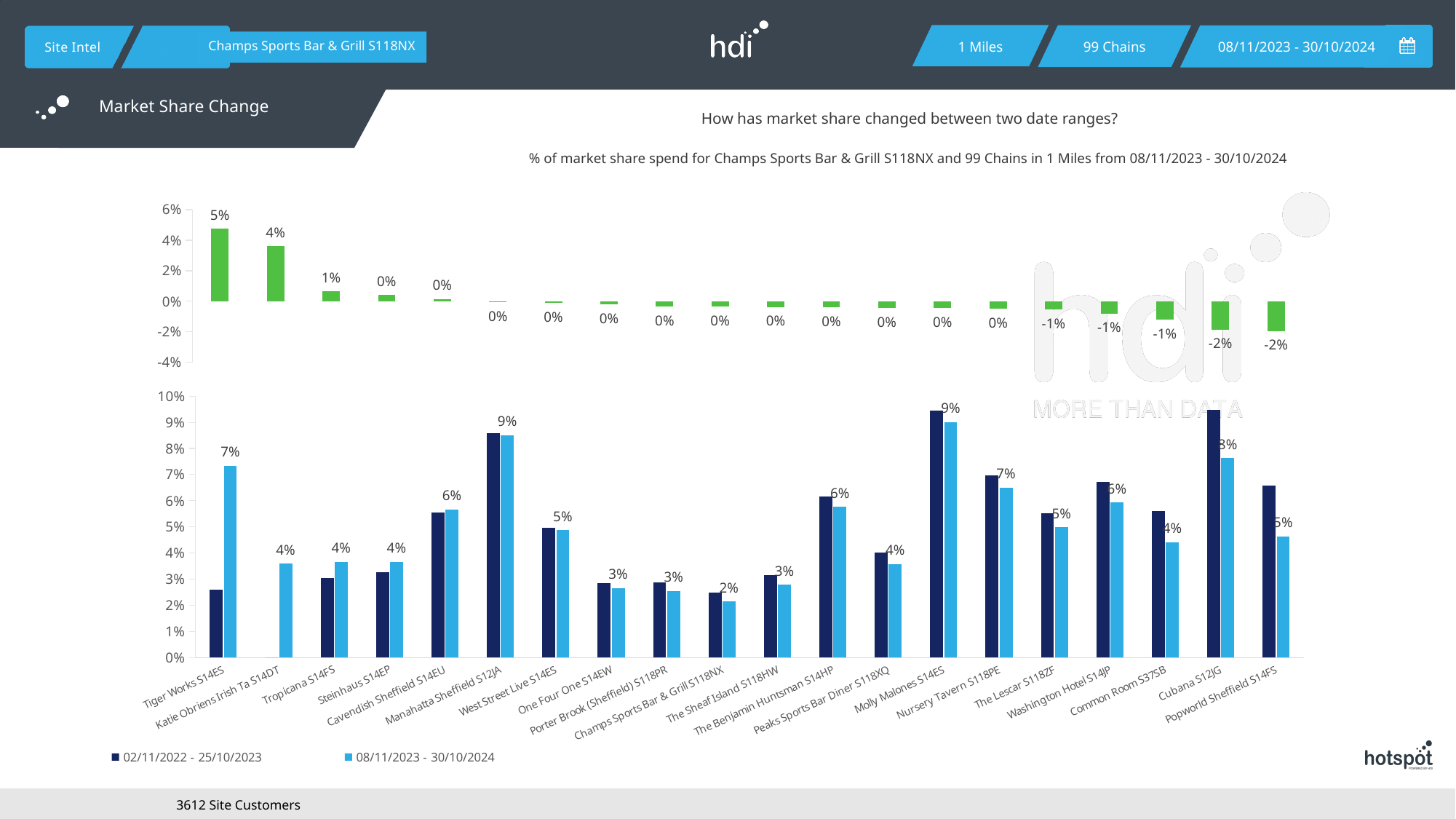
What kind of chart is the bottom chart? bar chart In the bottom chart, is the value for Washington Hotel S14JP in the 02/11/2022 - 25/10/2023 series greater or less than 6%? greater In the top chart (market share change), do the values generally rise or fall from left to right? fall In the bottom chart, for Tiger Works S14ES, which series has the larger value: 02/11/2022 - 25/10/2023 or 08/11/2023 - 30/10/2024? 08/11/2023 - 30/10/2024 In the top chart (market share change), what is the value for Tiger Works S14ES? 5% In the top chart (market share change), which category has the highest value? Tiger Works S14ES In the top chart (market share change), what is the difference between the values for Tiger Works S14ES and Katie Obriens Irish Ta S14DT? 1% In the top chart (market share change), what is the value for Cubana S12JG? -2% In the bottom chart, what is the value for Champs Sports Bar & Grill S118NX in the 08/11/2023 - 30/10/2024 series? 2% How many categories are shown on the x axis of the bottom chart? 20 In the bottom chart, how many series does the legend list? 2 In the bottom chart, what is the value for Manahatta Sheffield S12JA in the 08/11/2023 - 30/10/2024 series? 9%